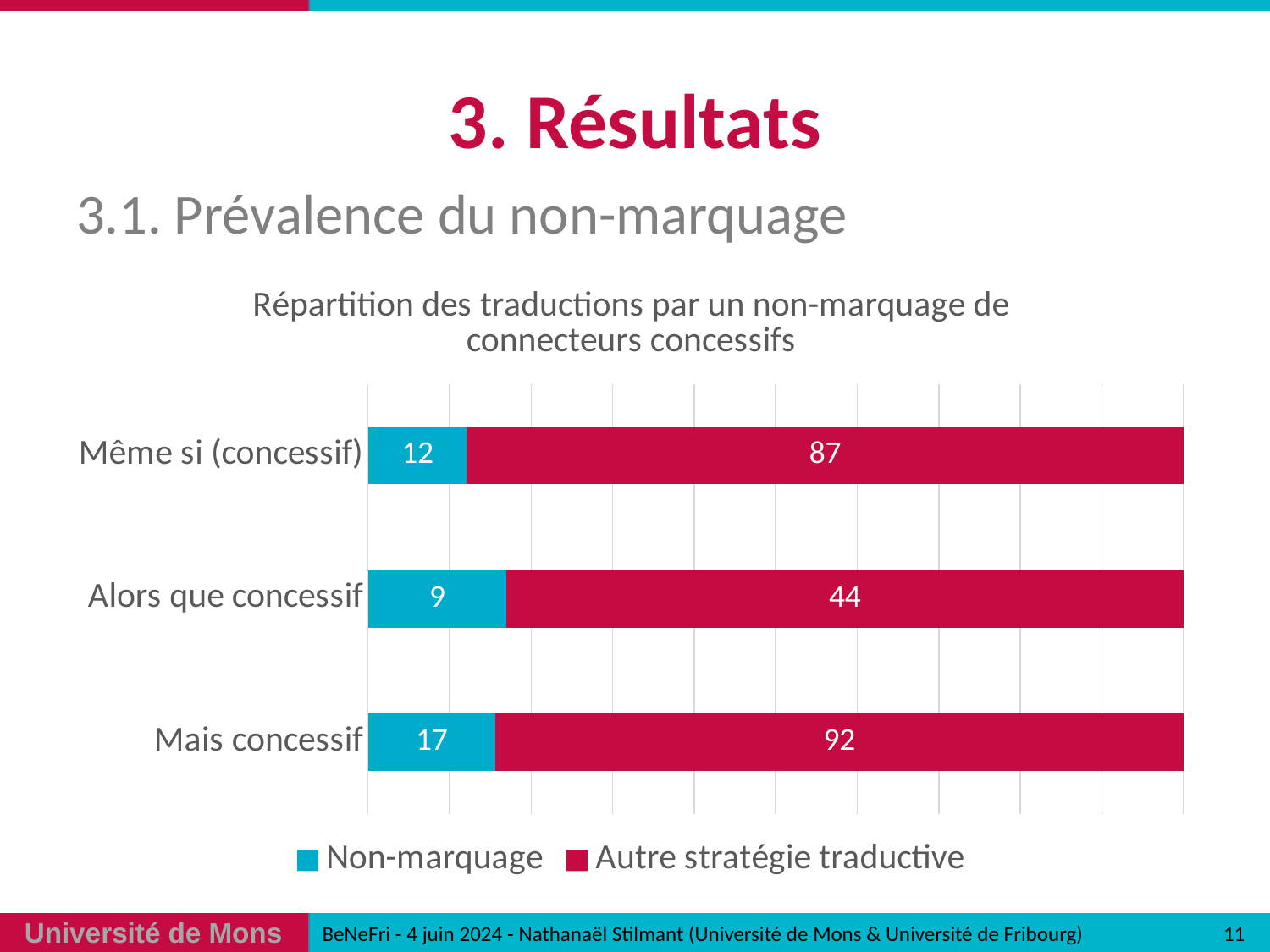
What is the total of the stacked bar for Alors que concessif? 53 What is the Non-marquage value for Même si (concessif)? 12 What kind of chart is shown on the slide? Stacked bar chart Which is larger: the Non-marquage value for Même si (concessif) or for Alors que concessif? Même si (concessif) What is the total of the stacked bar for Mais concessif? 109 What is the Non-marquage value for Mais concessif? 17 How many categories are shown on the chart? 3 What is the Autre stratégie traductive value for Alors que concessif? 44 What is the difference between the Autre stratégie traductive values for Mais concessif and Même si (concessif)? 5 How many series does the legend list? 2 Which category has the highest Non-marquage value? Mais concessif Which category has the lowest Autre stratégie traductive value? Alors que concessif